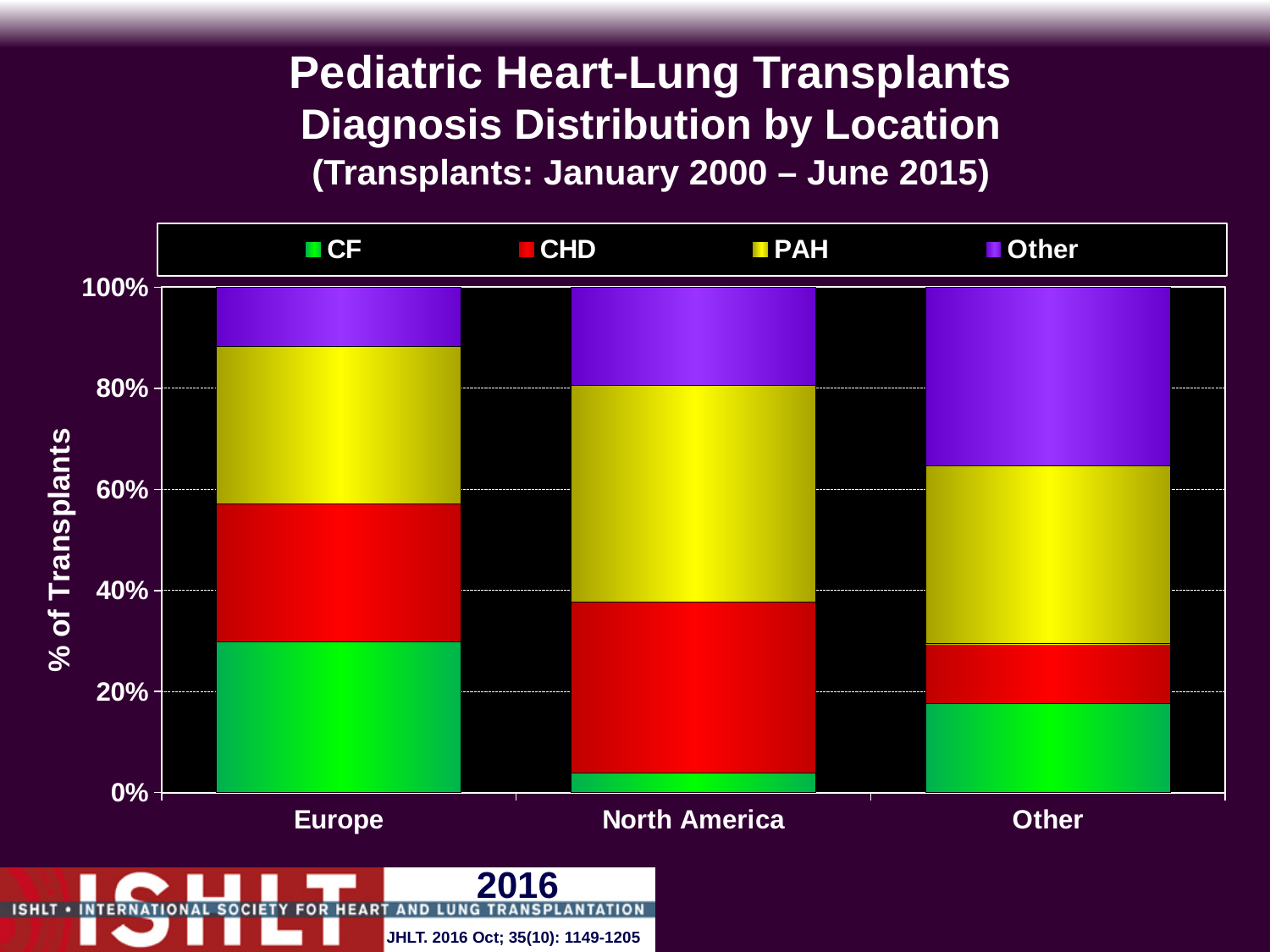
What is the total of the stacked bar for Europe? 100% What kind of chart is shown on the slide? Stacked bar chart Is the Other (purple) share for the Other location greater or less than 20%? greater Is the CF share for North America greater or less than 20%? less Which location has the smallest CF share? North America Which is larger, the PAH share for North America or the PAH share for Europe? North America Is the CF share for Europe greater or less than 20%? greater What is the label on the y axis? % of Transplants How many locations (categories) are shown on the x axis? 3 Which location has the largest CF share? Europe Which location has the largest CHD share? North America How many series does the legend list? 4